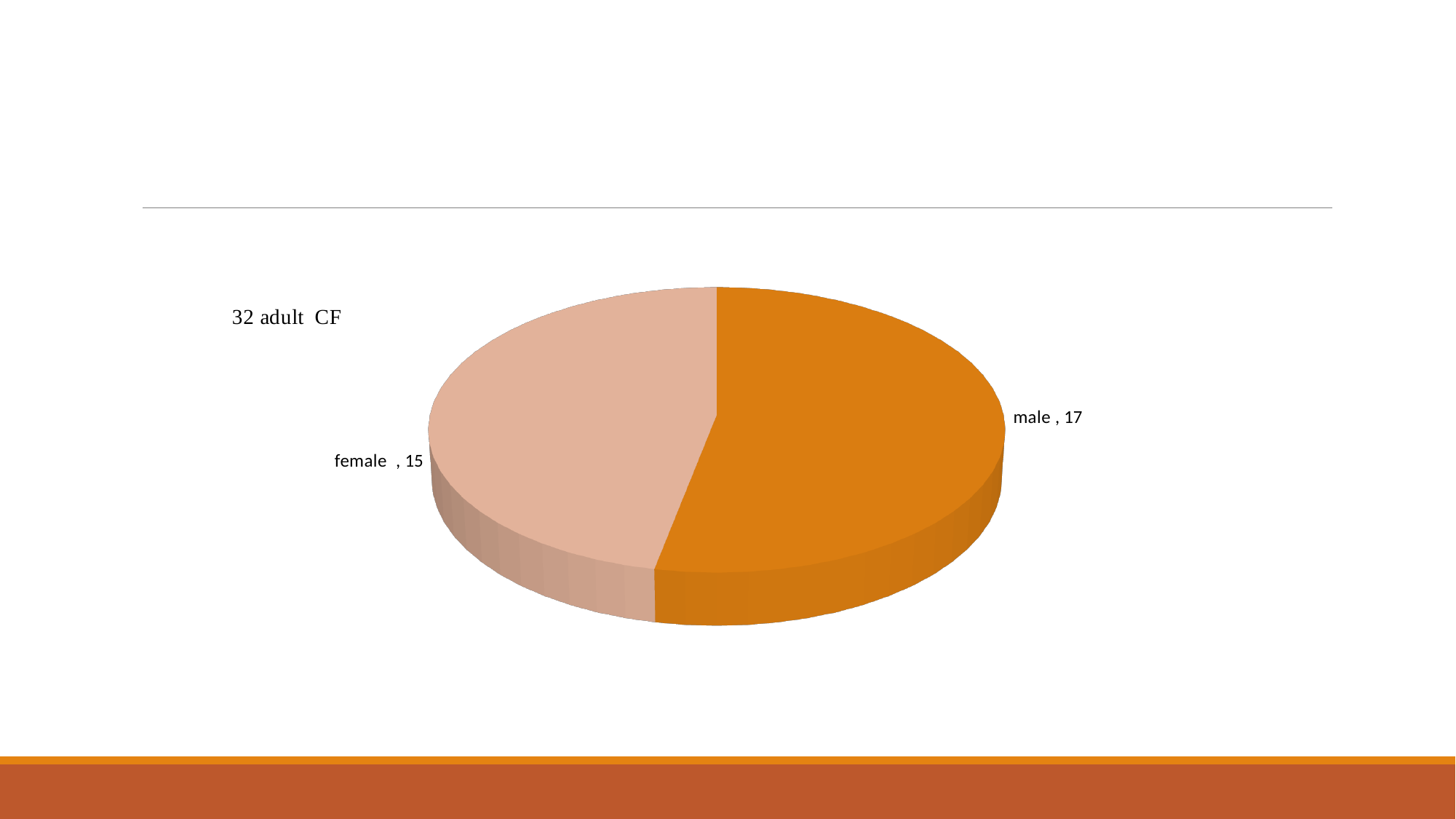
What kind of chart is shown on the slide? pie chart What is the total of the two slices? 32 How many slices does the pie chart have? 2 Which category has the largest slice? male What is the value for male? 17 What text appears to the left of the pie chart? 32 adult CF Which is larger, the value for male or the value for female? male What is the value for female? 15 Which category has the smallest slice? female Which slice is shown in the darker orange colour? male What is the difference between the male and female values? 2